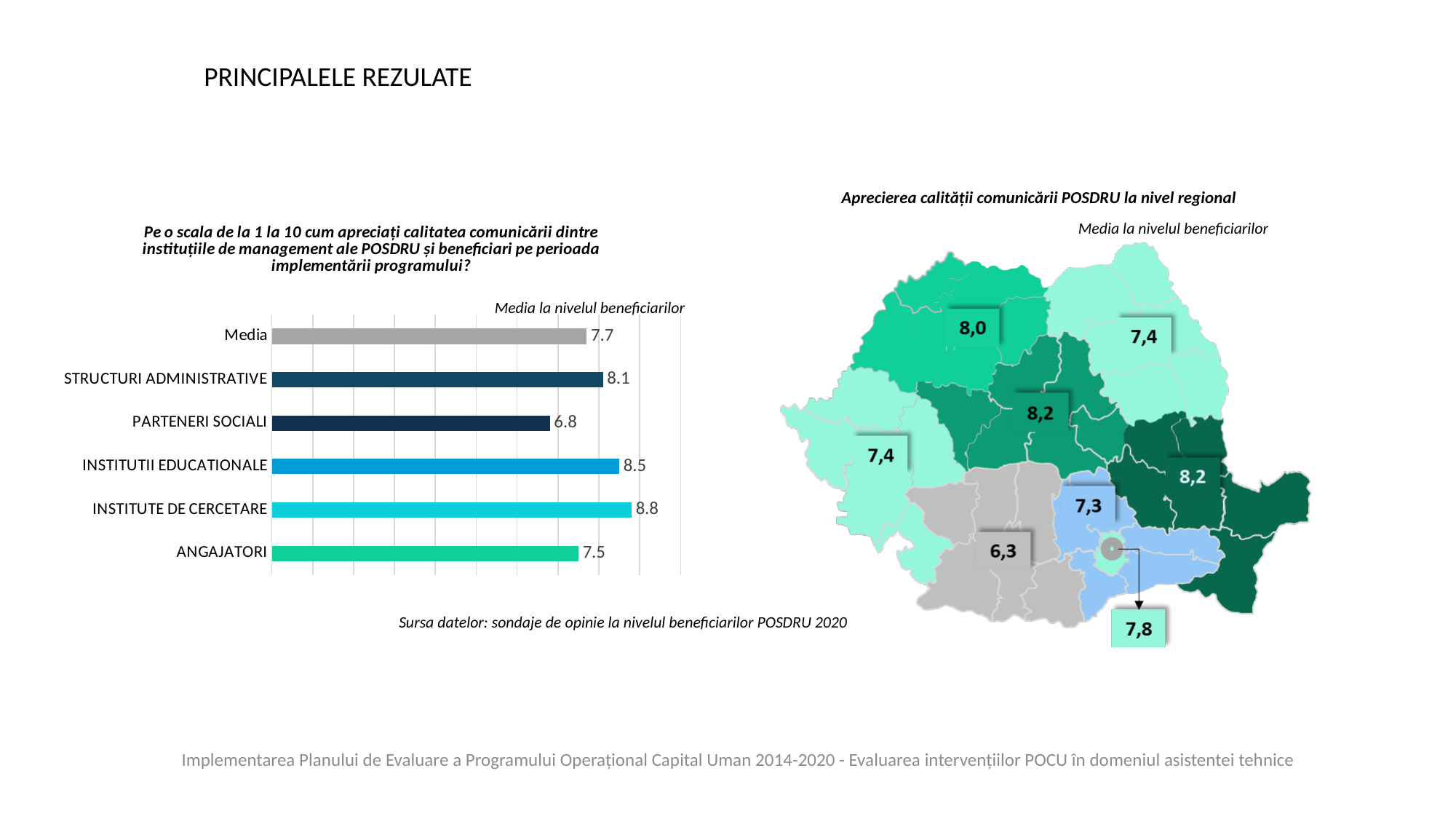
In the bar chart on the left, which category has the lowest value? PARTENERI SOCIALI In the bar chart on the left, what is the difference between the values for INSTITUTII EDUCATIONALE and ANGAJATORI? 1.0 What type of chart is shown on the left of the slide? Bar chart In the bar chart on the left, which is larger: STRUCTURI ADMINISTRATIVE or ANGAJATORI? STRUCTURI ADMINISTRATIVE In the bar chart on the left, what is the value for INSTITUTE DE CERCETARE? 8.8 In the bar chart on the left, what is the value for PARTENERI SOCIALI? 6.8 How many bars are shown in the bar chart on the left? 6 In the bar chart on the left, which category has the highest value? INSTITUTE DE CERCETARE In the map chart titled 'Aprecierea calității comunicării POSDRU la nivel regional', how many regional values are labelled? 8 In the map chart titled 'Aprecierea calității comunicării POSDRU la nivel regional', what is the lowest regional value shown? 6,3 In the bar chart on the left, what is the value for the Media bar? 7.7 In the bar chart on the left, what colour is the Media bar? Grey